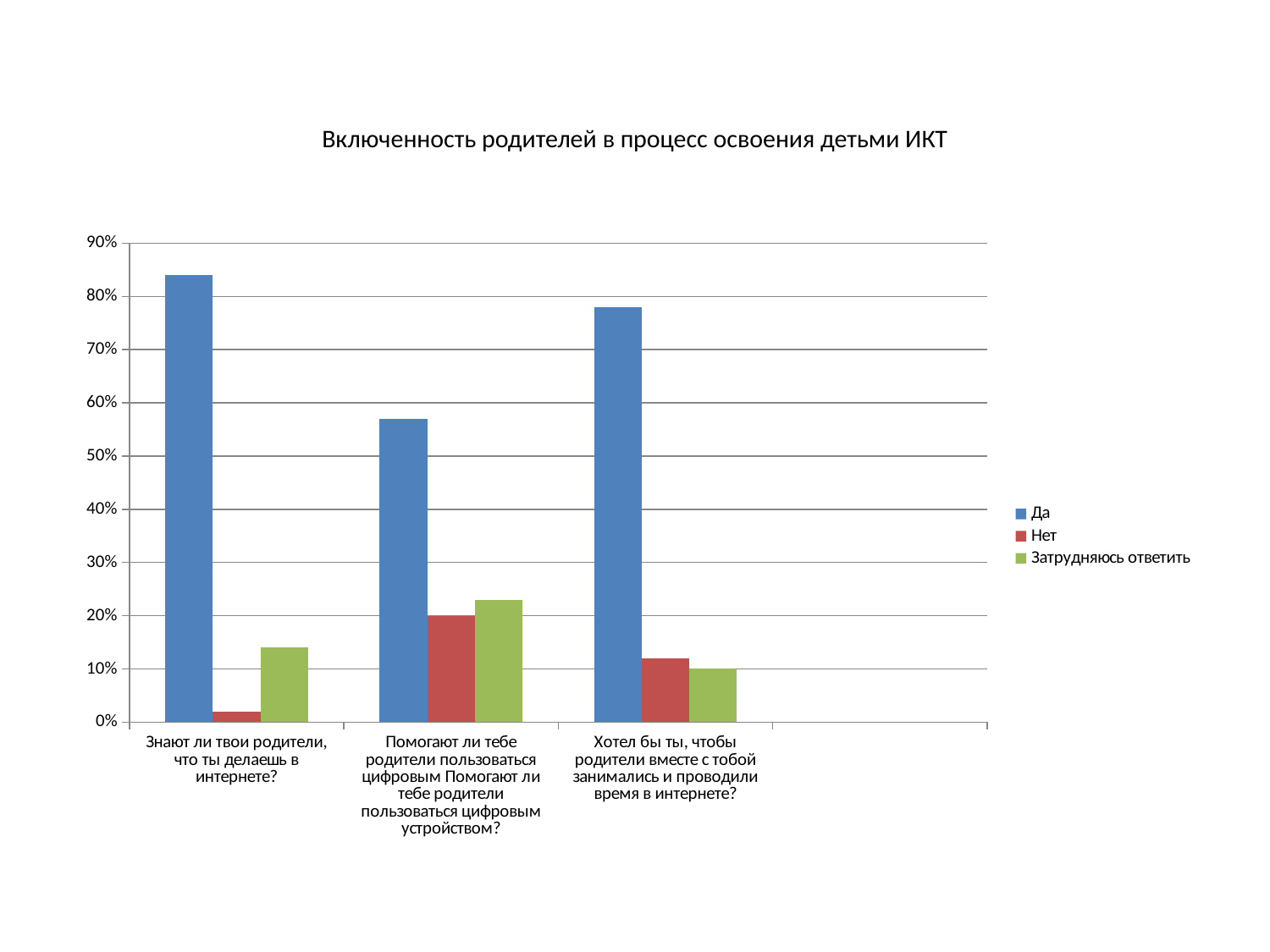
How many series does the legend list? 3 How many question categories are shown on the x axis? 3 Is the 'Да' value for 'Хотел бы ты, чтобы родители вместе с тобой занимались и проводили время в интернете?' greater or less than 70%? greater For which question is the 'Да' value highest? Знают ли твои родители, что ты делаешь в интернете? What is the title of the chart? Включенность родителей в процесс освоения детьми ИКТ For 'Помогают ли тебе родители пользоваться цифровым устройством?', which is larger: the 'Нет' value or the 'Затрудняюсь ответить' value? Затрудняюсь ответить Which series is shown in blue? Да For which question is the 'Да' value lowest? Помогают ли тебе родители пользоваться цифровым Помогают ли тебе родители пользоваться цифровым устройством? For which question is the 'Нет' value lowest? Знают ли твои родители, что ты делаешь в интернете? Is the 'Нет' value for 'Знают ли твои родители, что ты делаешь в интернете?' greater or less than 10%? less Is the 'Да' value for 'Знают ли твои родители, что ты делаешь в интернете?' greater or less than 80%? greater What type of chart is shown on the slide? bar chart